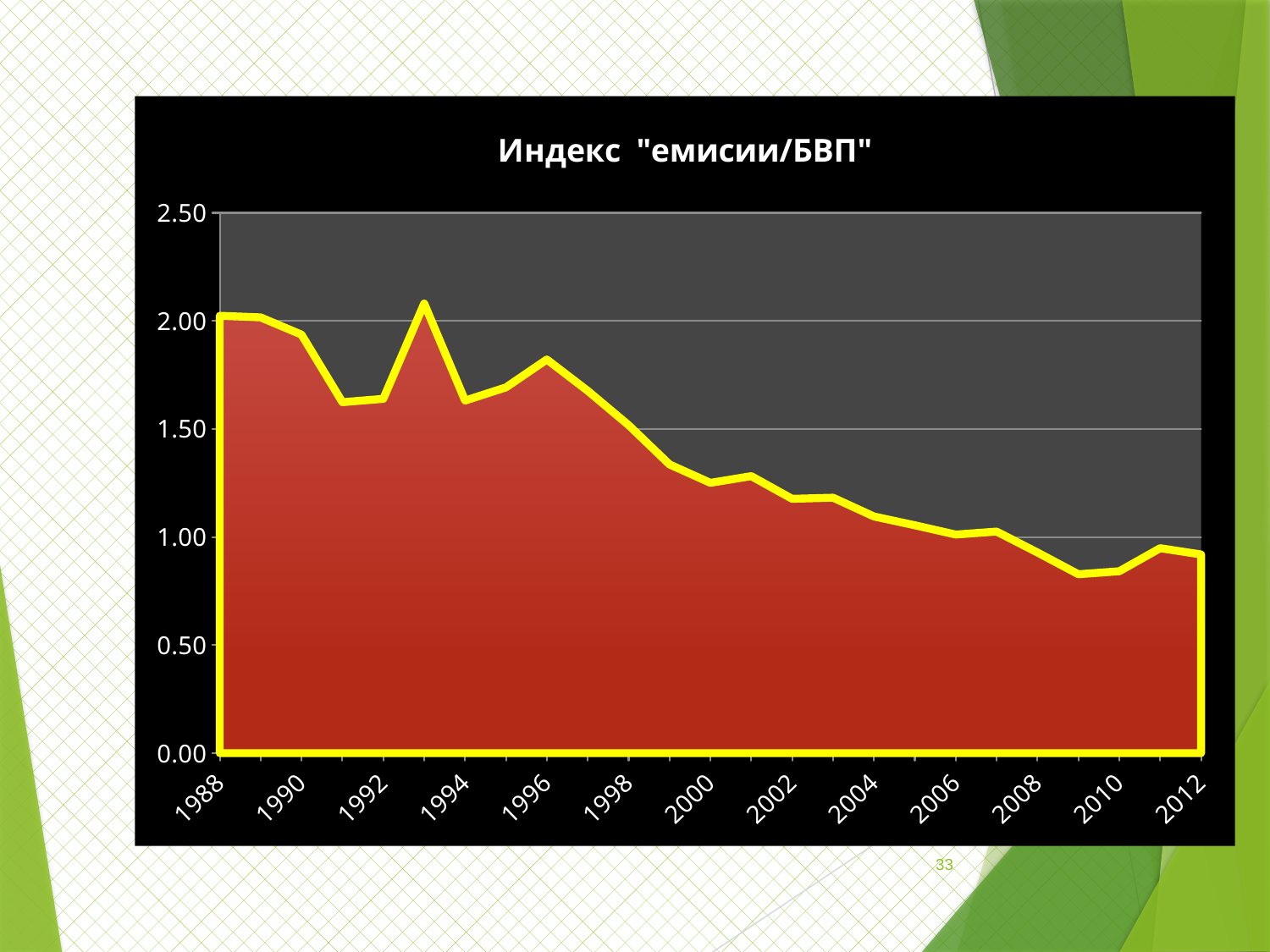
Is the value for 1992 greater or less than 1.50? greater What kind of chart is shown on the slide? area chart How many year labels are shown on the x axis? 13 Overall, do the values rise or fall from 1988 to 2012? fall Is the highest point on the chart greater or less than 2.00? greater Is the value for 1996 greater or less than 1.50? greater Which year has the larger value, 1996 or 2000? 1996 Which year has the larger value, 1990 or 2010? 1990 What is the title of the chart? Индекс "емисии/БВП"